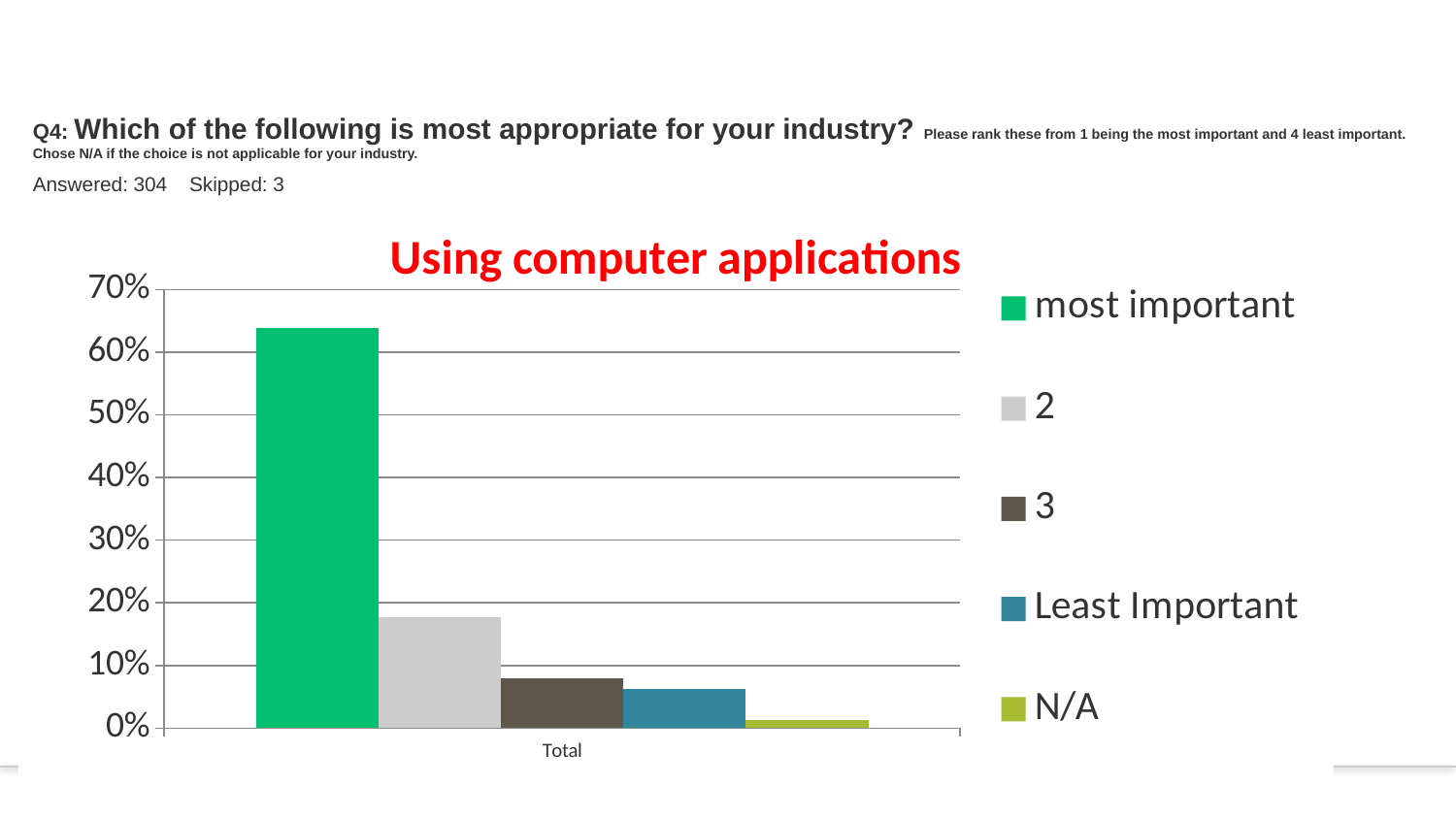
Which is larger, the value for '2' or the value for 'Least Important'? 2 Which series has the highest value? most important Is the value for '2' greater or less than 20%? less What is the title of the chart? Using computer applications How many categories are shown on the x axis? 1 Is the value for '2' greater or less than 10%? greater Is the value for '3' greater or less than 10%? less How many series does the legend list? 5 Which series has the lowest value? N/A What kind of chart is shown on the slide? bar chart What is the label of the category on the x axis? Total